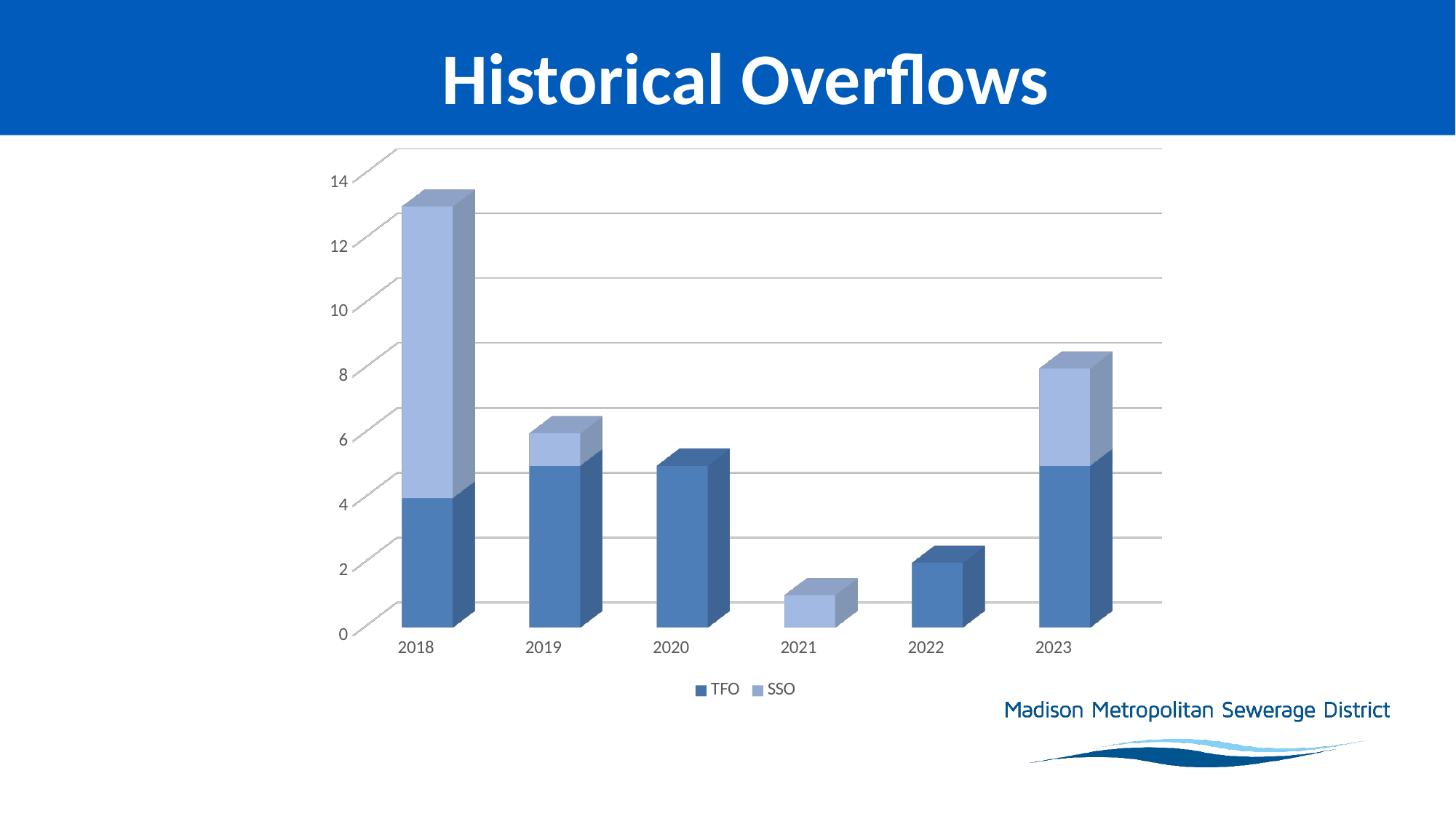
Is the total for 2021 greater or less than 2? less Which year has the highest total overflows? 2018 What is the title of the slide? Historical Overflows How many years are shown on the x axis? 6 Is the total for 2023 greater or less than 6? greater Which year has a larger total, 2019 or 2023? 2023 Is the total for 2018 greater or less than 12? greater Which series is shown in the lighter blue colour? SSO Which year has the lowest total overflows? 2021 How many series does the legend list? 2 What type of chart is shown on the slide? bar chart What is the TFO value for 2022? 2